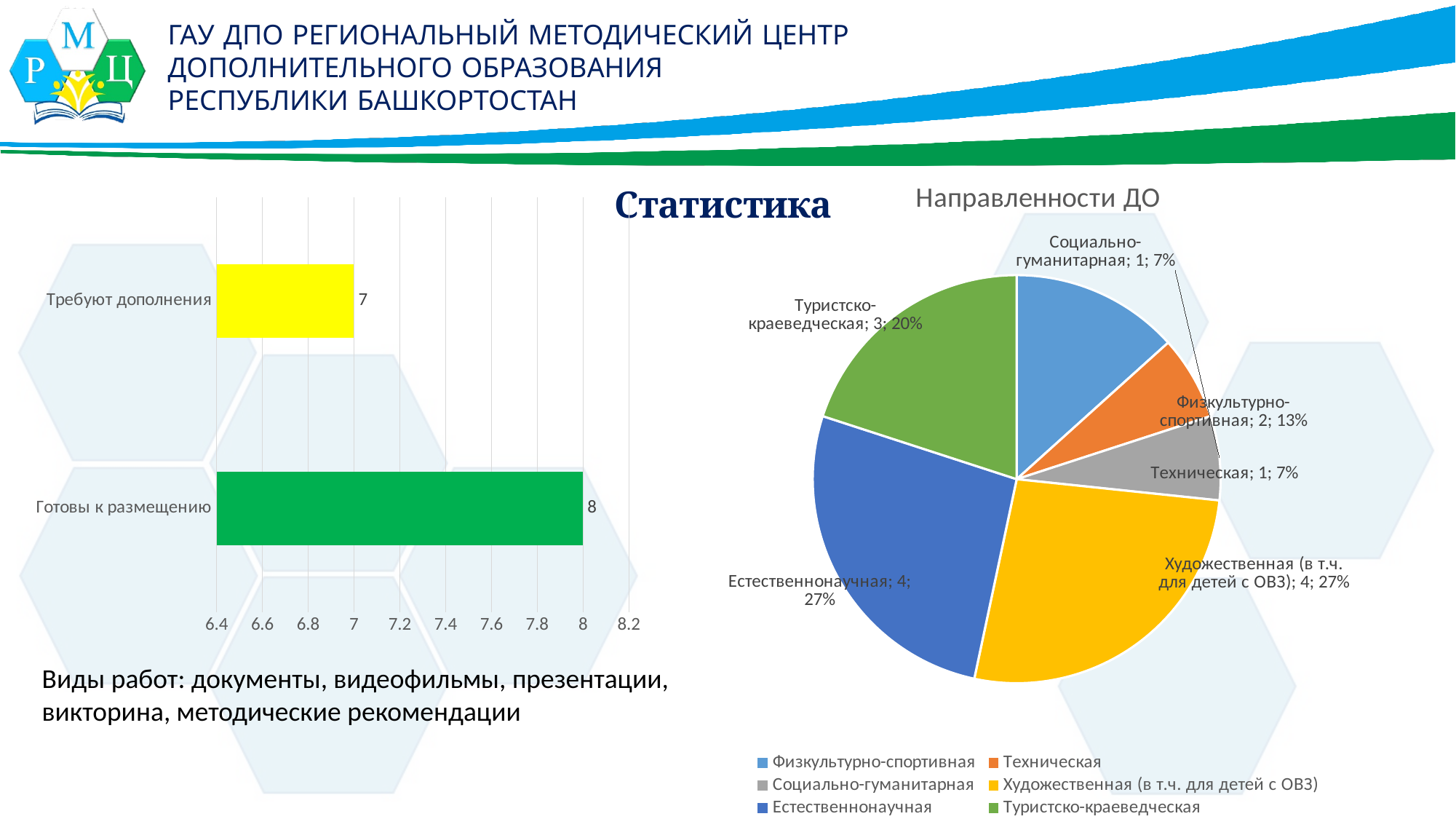
On the pie chart Направленности ДО, what share does Туристско-краеведческая have? 20% On the bar chart on the left, which category has the higher value? Готовы к размещению On the bar chart on the left, what is the value for Требуют дополнения? 7 On the pie chart Направленности ДО, which is larger: Естественнонаучная or Туристско-краеведческая? Естественнонаучная On the bar chart on the left, how many categories are shown? 2 On the pie chart Направленности ДО, what share does Техническая have? 7% On the bar chart on the left, what is the difference between Готовы к размещению and Требуют дополнения? 1 What is the title of the pie chart on the right? Направленности ДО What type of chart is the chart on the left of the slide? bar chart On the pie chart Направленности ДО, how many entries does the legend list? 6 On the pie chart Направленности ДО, what is the value for Физкультурно-спортивная? 2 On the bar chart on the left, what is the value for Готовы к размещению? 8